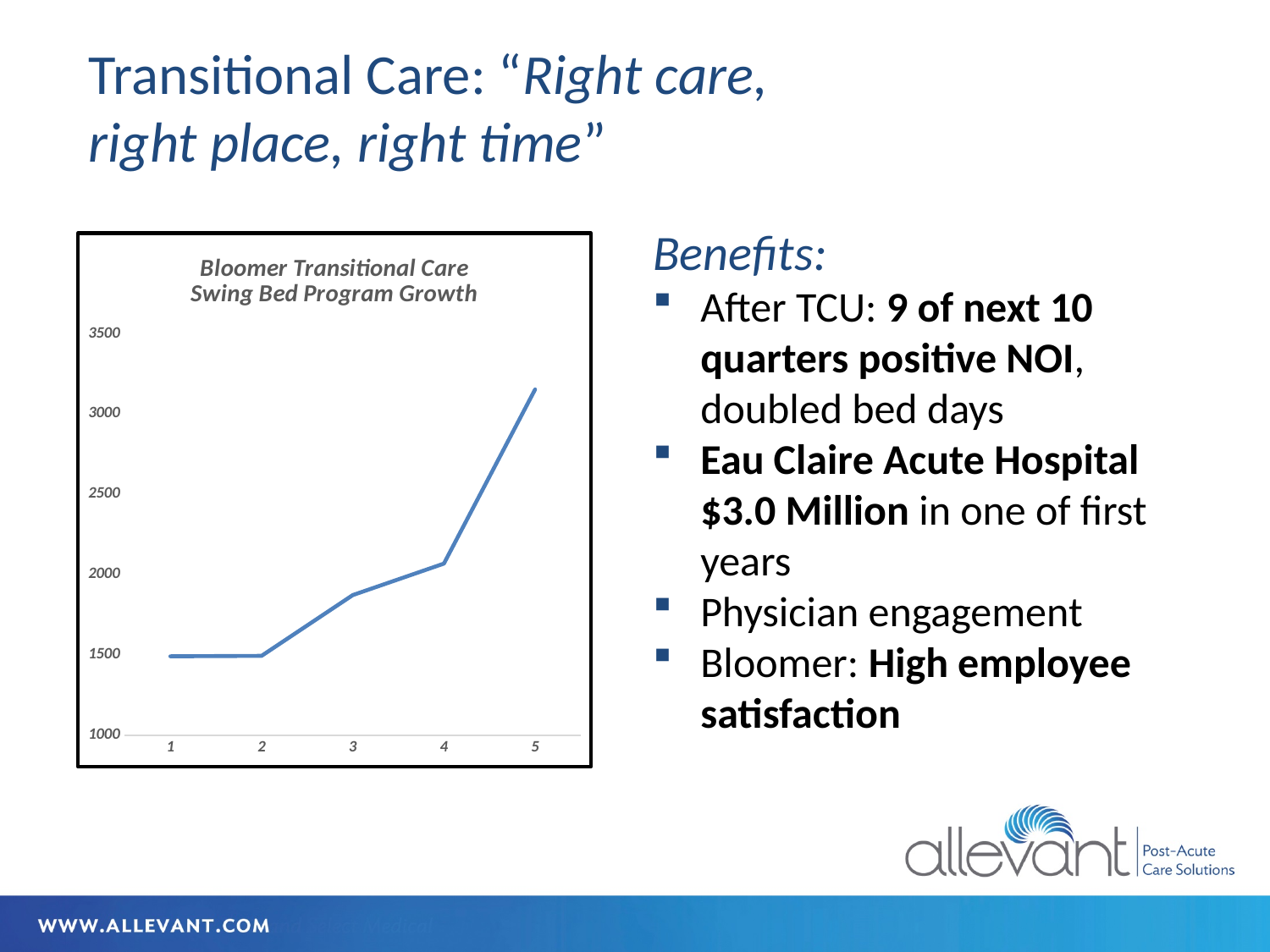
What kind of chart is shown on the slide? line chart How many points are plotted on the line? 5 Which x-axis category has the highest value? 5 What is the highest value shown on the y axis? 3500 Do the values generally rise or fall from category 1 to category 5? rise Is the value for category 1 greater or less than 2000? less Is the value for category 5 greater or less than 3000? greater What is the title of the chart? Bloomer Transitional Care Swing Bed Program Growth Which has the larger value, category 2 or category 4? 4 Which has the larger value, category 3 or category 5? 5 Is the value for category 4 greater or less than 2500? less